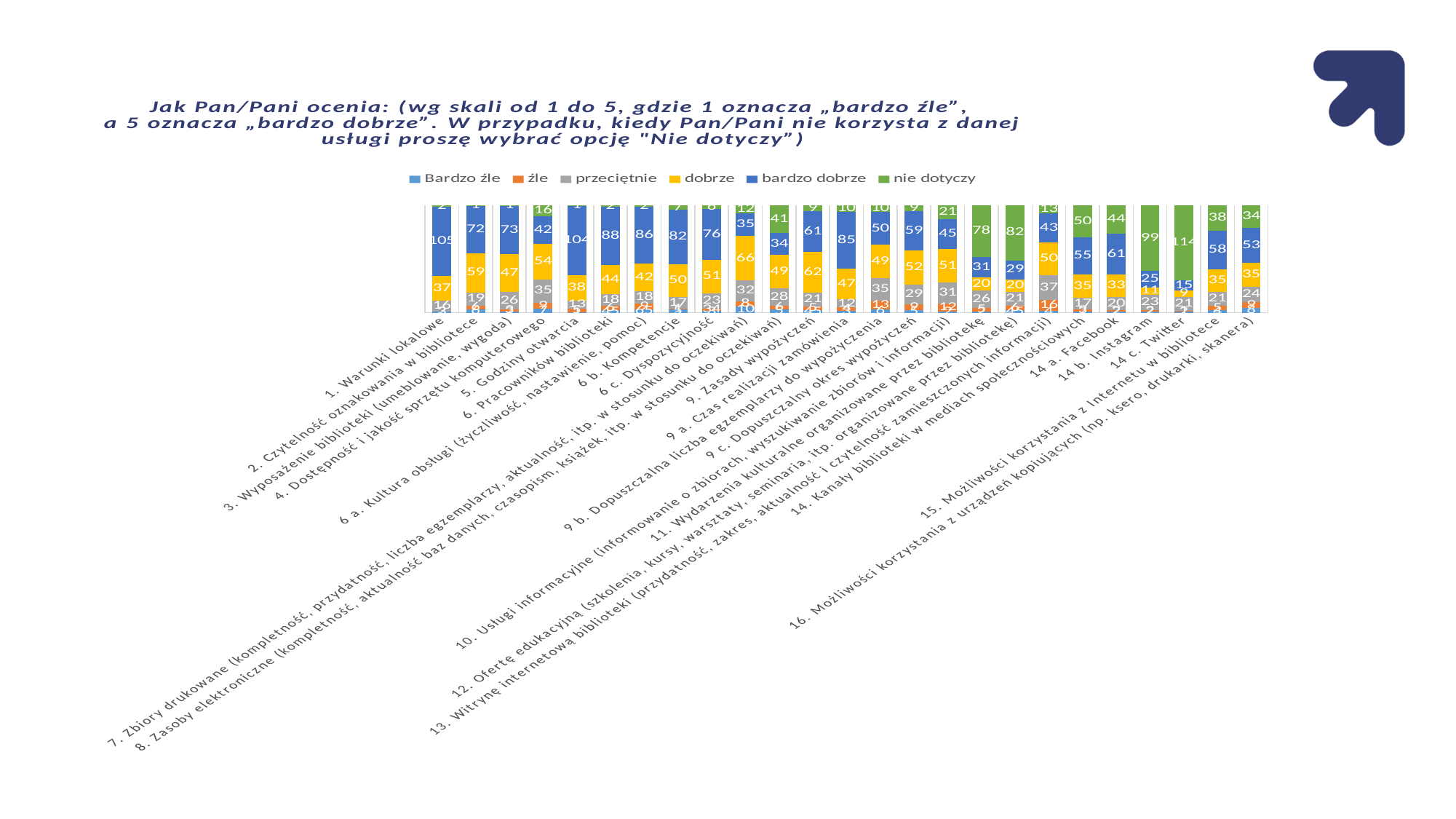
What is the difference between the 'bardzo dobrze' and 'dobrze' values for '1. Warunki lokalowe'? 68 For '1. Warunki lokalowe', which is larger: the 'bardzo dobrze' value or the 'dobrze' value? bardzo dobrze What kind of chart is shown on the slide? stacked bar chart What colour represents the 'nie dotyczy' series? green What is the 'nie dotyczy' value for '16. Możliwości korzystania z urządzeń kopiujących (np. ksero, drukarki, skanera)'? 34 What is the largest 'nie dotyczy' value shown in the chart? 114 Which category has the highest 'bardzo dobrze' value? 1. Warunki lokalowe What is the 'dobrze' value for '1. Warunki lokalowe'? 37 What is the first entry in the legend? Bardzo źle What is the 'bardzo dobrze' value for '1. Warunki lokalowe'? 105 How many series does the legend list? 6 What is the 'przeciętnie' value for '1. Warunki lokalowe'? 16